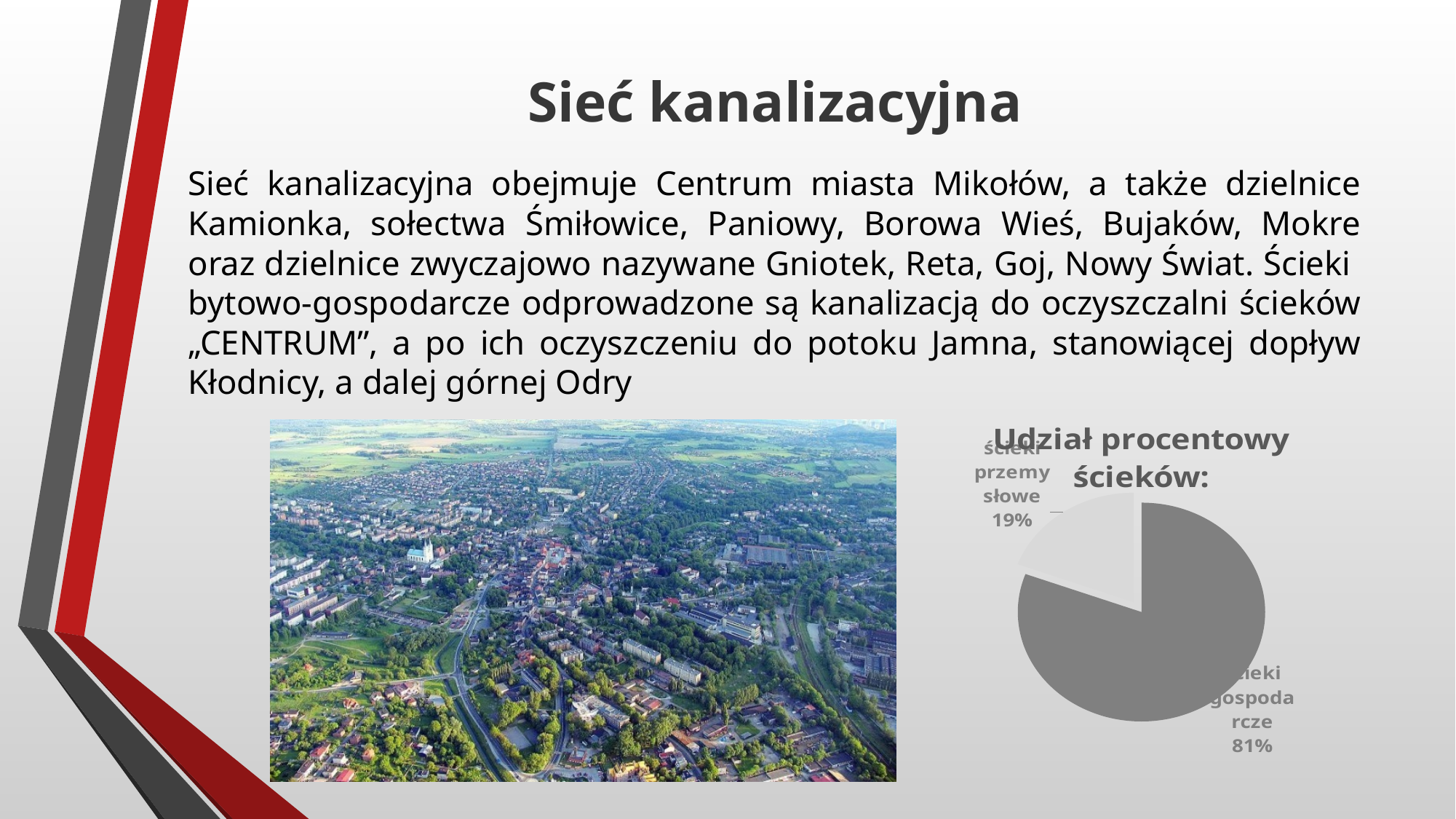
What is the title of the pie chart? Udział procentowy ścieków: Is the share of 'ścieki gospodarcze' in the pie chart greater or less than 50%? greater What is the share of the 'ścieki przemysłowe' slice in the pie chart? 19% Which slice of the pie chart is the largest? ścieki gospodarcze What is the difference in percentage points between the 'ścieki gospodarcze' and 'ścieki przemysłowe' slices? 62 What kind of chart is shown on the slide? pie chart How many slices does the pie chart have? 2 Which slice of the pie chart is the smallest? ścieki przemysłowe Which is larger in the pie chart: 'ścieki przemysłowe' or 'ścieki gospodarcze'? ścieki gospodarcze What percentage share does the 'ścieki przemysłowe' slice have in the pie chart? 19% What percentage share does the 'ścieki gospodarcze' slice have in the pie chart? 81%